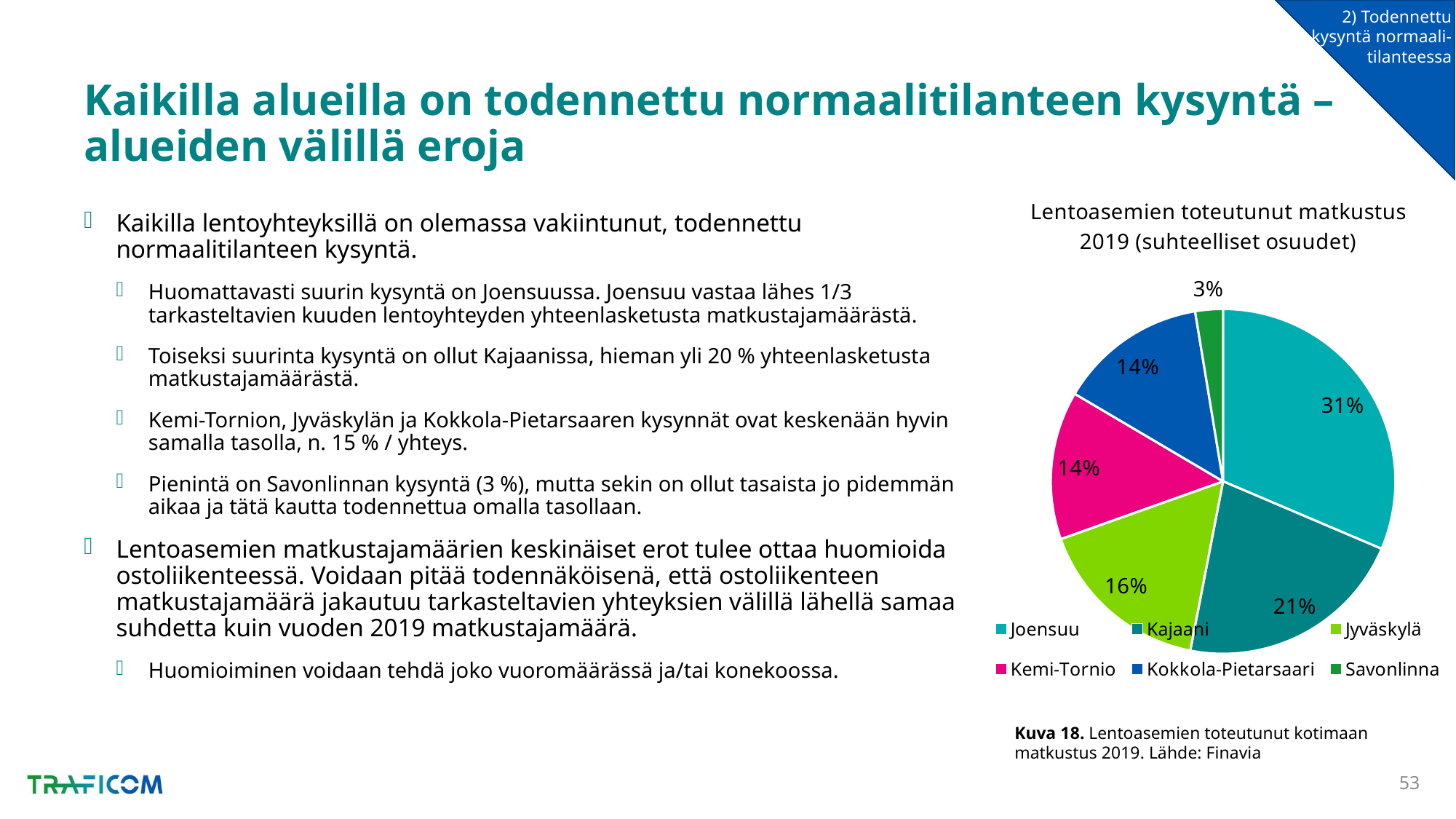
Which is larger, the share for Jyväskylä or the share for Kokkola-Pietarsaari? Jyväskylä What is the value shown for Jyväskylä? 16% Which airport has the smallest slice of the pie? Savonlinna What is the value shown for Savonlinna? 3% What is the value shown for Kemi-Tornio? 14% Which airport has the largest slice of the pie? Joensuu What is the title of the chart? Lentoasemien toteutunut matkustus 2019 (suhteelliset osuudet) What share of the pie does Joensuu have? 31% What type of chart is shown on the slide? Pie chart What share of the pie does Kajaani have? 21% What is the difference in percentage points between Joensuu and Kajaani? 10 How many airports are shown in the pie chart? 6